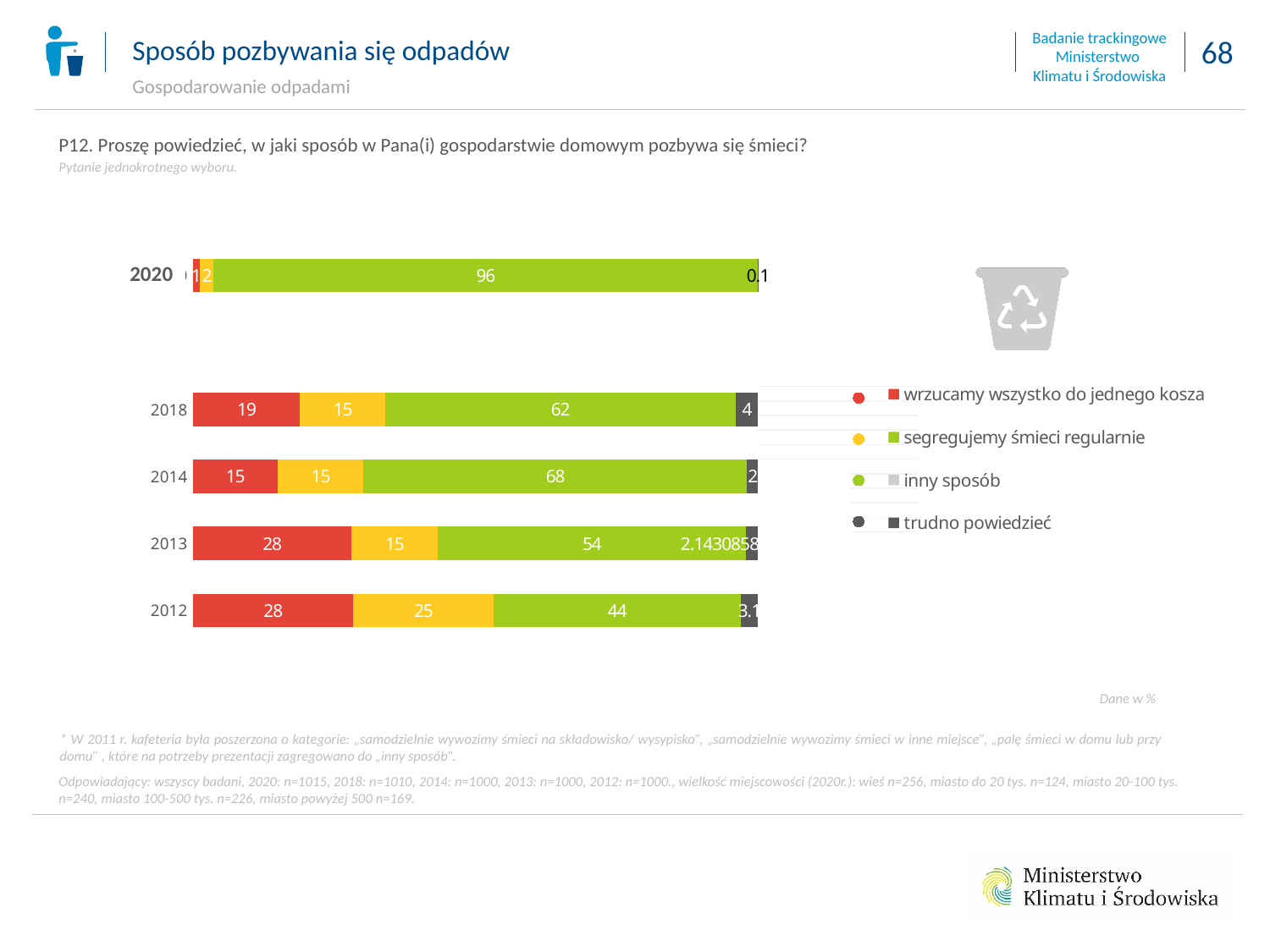
Does the green segment increase or decrease from 2012 to 2020? increase What is the total of the stacked bar for 2018? 100 What is the value of the yellow segment for 2012? 25 What is the difference between the green segment values for 2014 and 2018? 6 Which year has the largest green segment? 2020 What is the value of the red segment for 2012? 28 How many years (categories) are shown on the chart? 5 Which year has the larger red segment, 2018 or 2014? 2018 What is the value of the dark grey segment for 2018? 4 How many series does the legend list? 4 What is the value of the green segment for 2020? 96 What kind of chart is shown on the slide? stacked bar chart